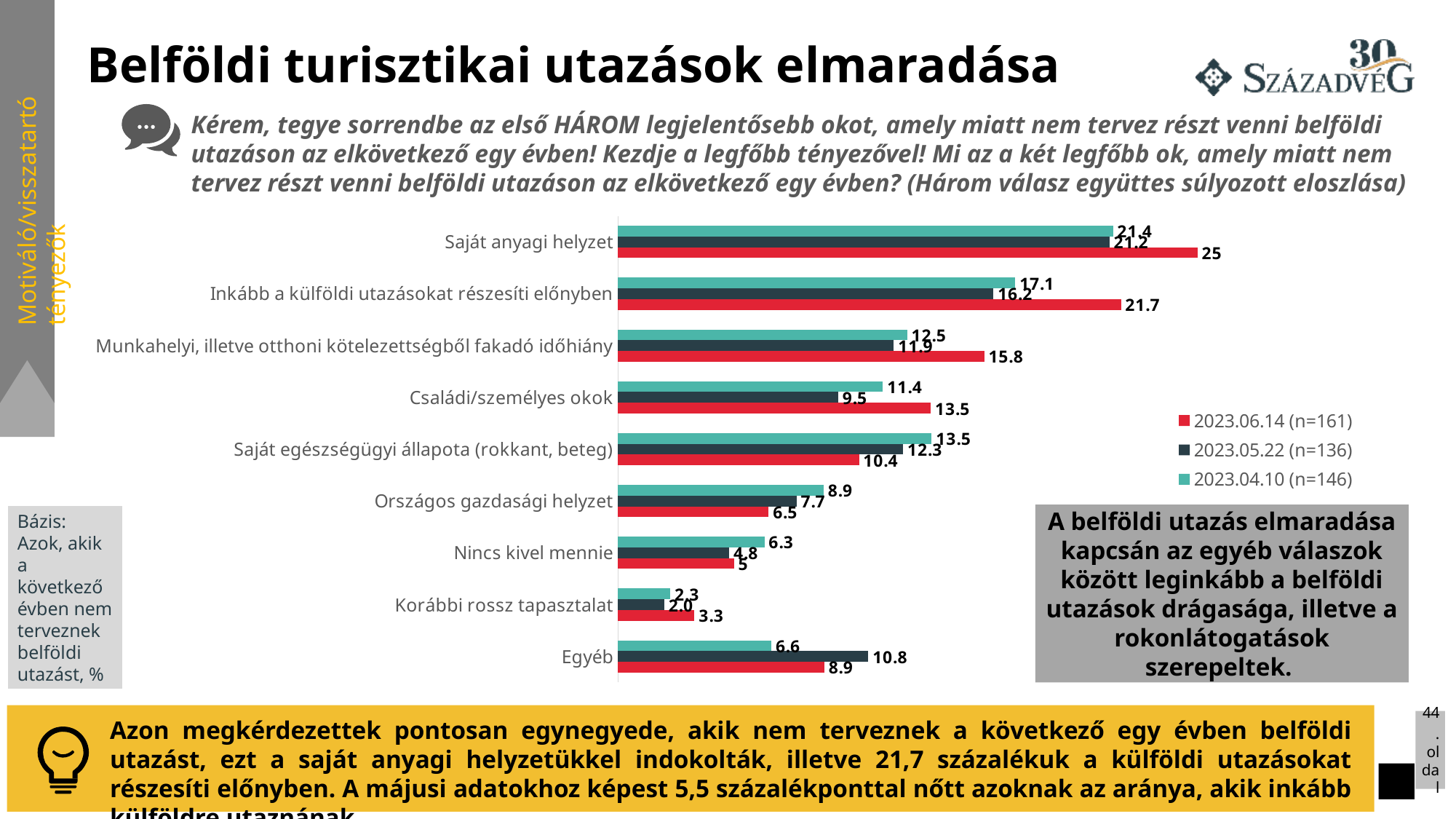
What is the value for "Egyéb" in the 2023.04.10 (n=146) series? 6.6 What is the value for "Inkább a külföldi utazásokat részesíti előnyben" in the 2023.05.22 (n=136) series? 16.2 How many categories are shown on the chart? 9 How many series does the legend list? 3 What is the value for "Saját anyagi helyzet" in the 2023.06.14 (n=161) series? 25 What is the difference between the 2023.06.14 (n=161) and 2023.05.22 (n=136) values for "Inkább a külföldi utazásokat részesíti előnyben"? 5.5 For "Egyéb", which series has the larger value: 2023.05.22 (n=136) or 2023.06.14 (n=161)? 2023.05.22 (n=136) What kind of chart is shown on the slide? Bar chart Which category has the highest value in the 2023.06.14 (n=161) series? Saját anyagi helyzet For "Saját egészségügyi állapota (rokkant, beteg)", which series has the larger value: 2023.06.14 (n=161) or 2023.04.10 (n=146)? 2023.04.10 (n=146) Which category has the lowest value in the 2023.04.10 (n=146) series? Korábbi rossz tapasztalat What colour represents the 2023.06.14 (n=161) series? Red